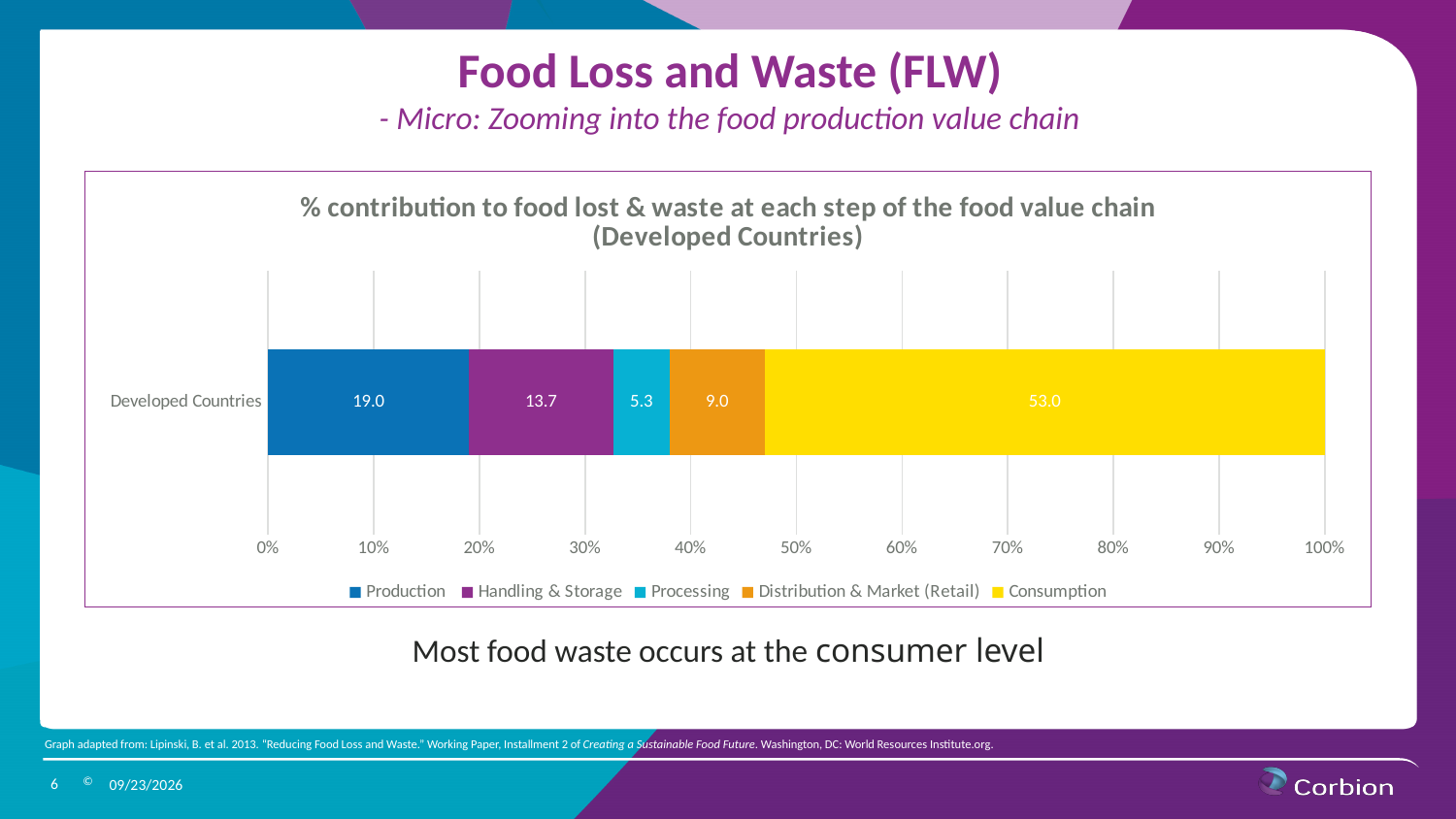
What is the total of the stacked bar for Developed Countries? 100.0 Which series has the smallest value in the bar? Processing What kind of chart is shown on the slide? Stacked bar chart What is the value for Consumption? 53.0 What is the value for Production in the stacked bar? 19.0 How many series does the legend list? 5 Which series has the largest value in the bar? Consumption What is the value for Processing? 5.3 What is the value for Distribution & Market (Retail)? 9.0 What is the difference between the Consumption value and the Production value? 34.0 What is the value for Handling & Storage? 13.7 Which is larger, the value for Handling & Storage or the value for Distribution & Market (Retail)? Handling & Storage